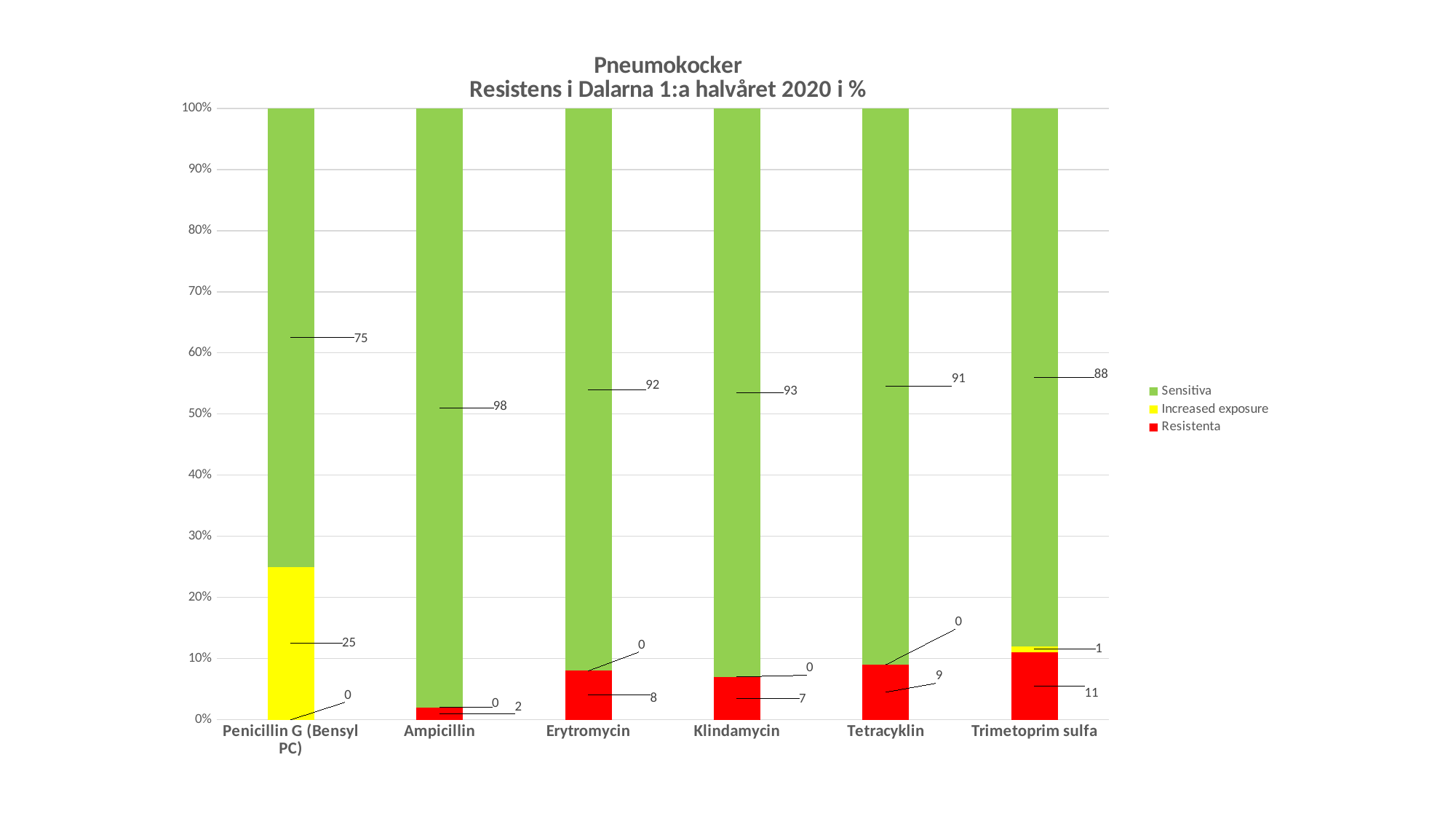
Which antibiotic has the lowest Sensitiva value? Penicillin G (Bensyl PC) What is the Sensitiva value for Penicillin G (Bensyl PC)? 75 Which has a larger Resistenta value, Erytromycin or Klindamycin? Erytromycin Which antibiotic has the highest Sensitiva value? Ampicillin What is the Resistenta value for Trimetoprim sulfa? 11 How many series does the legend list? 3 How many antibiotics are shown on the x axis? 6 What kind of chart is shown on the slide? Stacked bar chart What is the Increased exposure value for Penicillin G (Bensyl PC)? 25 What is the Resistenta value for Tetracyklin? 9 What is the difference between the Sensitiva values for Ampicillin and Trimetoprim sulfa? 10 What is the Sensitiva value for Ampicillin? 98